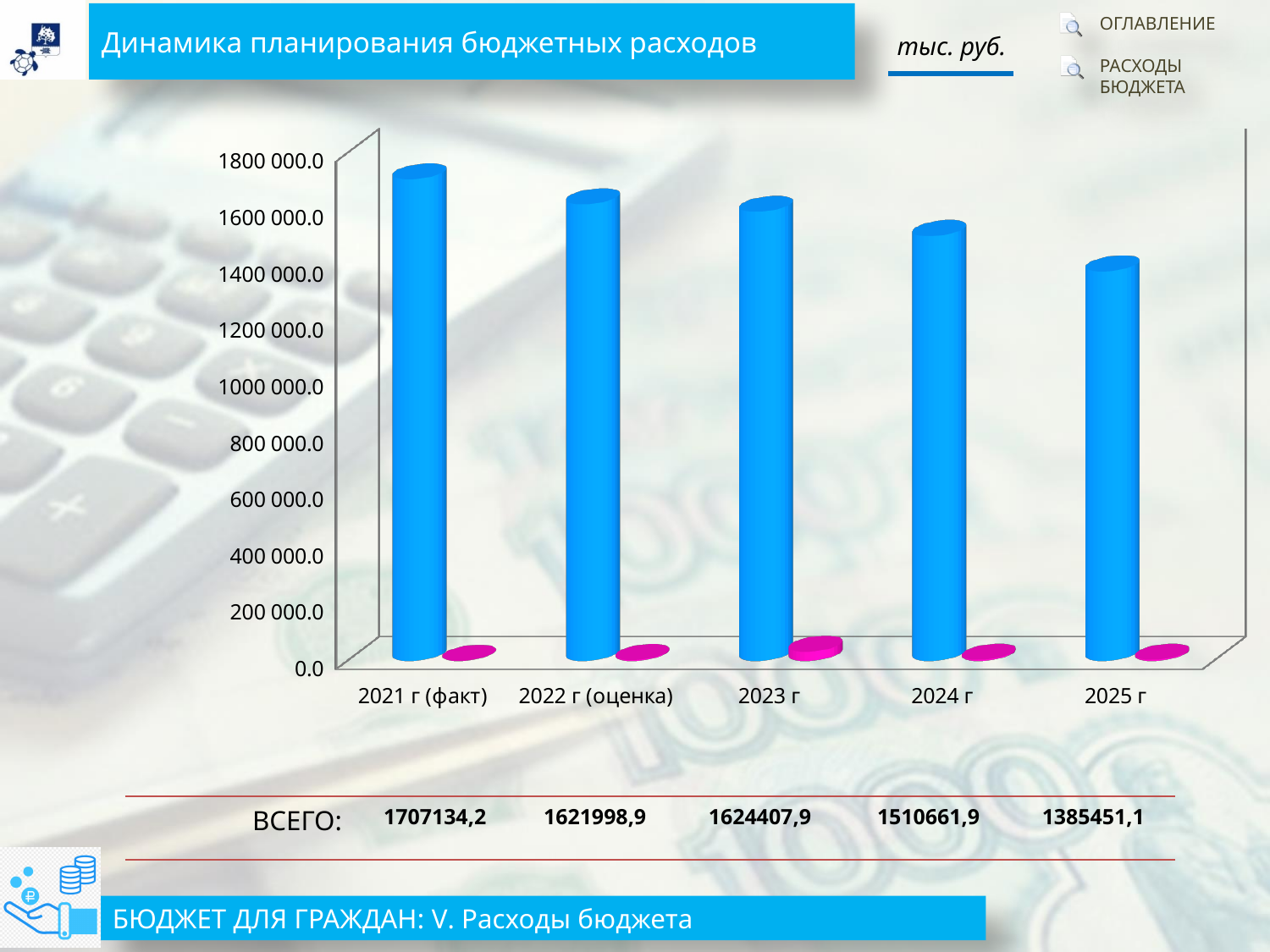
According to the ВСЕГО row, what is the value for 2024 г? 1510661,9 Using the ВСЕГО values, what is the difference between 2024 г and 2025 г? 125210,8 Is the bar for 2024 г greater or less than 1600 000.0? less How many categories (years) are shown on the x axis of the chart? 5 Using the ВСЕГО values, what is the difference between 2021 г (факт) and 2025 г? 321683,1 What is the title of the chart on the slide? Динамика планирования бюджетных расходов Which year has the tallest bar in the chart? 2021 г (факт) According to the ВСЕГО row, what is the value for 2025 г? 1385451,1 Which year has the shortest bar in the chart? 2025 г What kind of chart is shown on the slide? bar chart According to the ВСЕГО row, what is the value for 2021 г (факт)? 1707134,2 Is the bar for 2021 г (факт) greater or less than 1600 000.0? greater